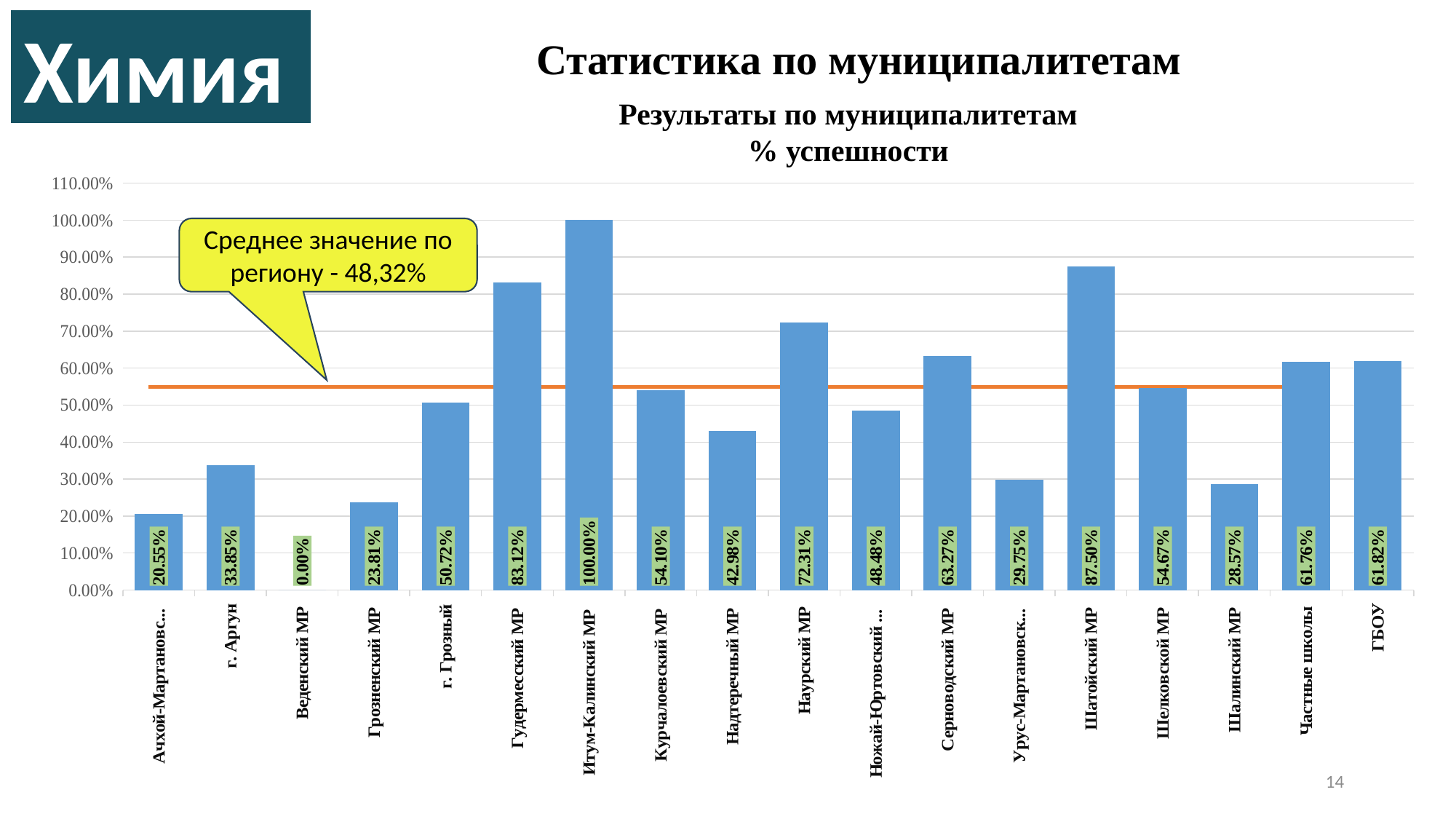
What is the value for Шелковской МР? 54.67% What is the value for Наурский МР? 72.31% What kind of chart is shown on the slide? bar chart What is the value for Частные школы? 61.76% What is the difference between the values for Шатойский МР and Серноводский МР? 24.23% Which category has the highest value? Итум-Калинский МР What average value for the region is stated in the callout on the chart? 48,32% What is the value for Гудермесский МР? 83.12% Is the value for Надтеречный МР greater or less than 50.00%? less Which category has the lowest value? Веденский МР Which is larger, the value for г. Аргун or the value for Грозненский МР? г. Аргун How many categories are shown on the x axis? 18